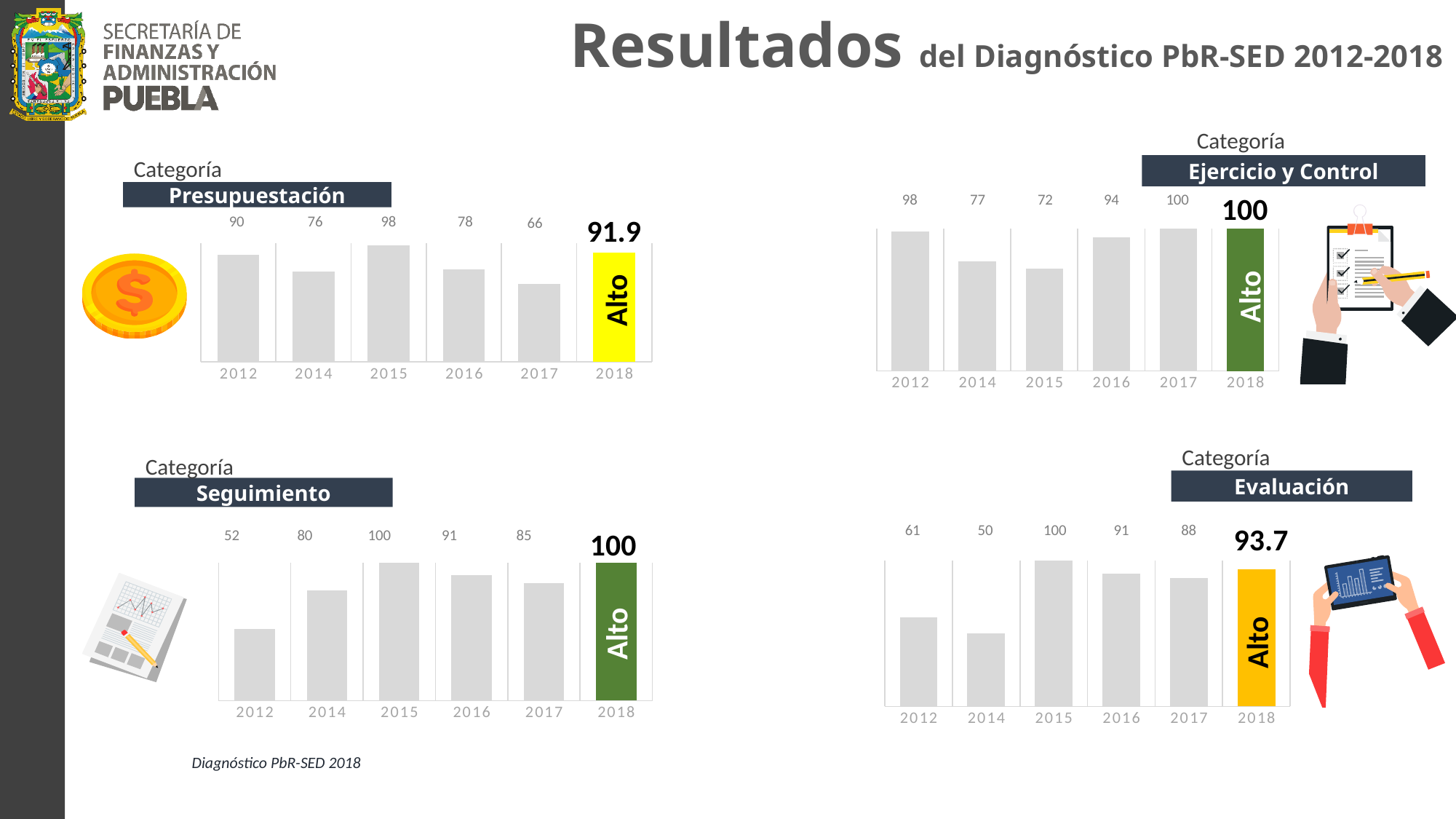
In the Evaluación chart, what is the value for 2018? 93.7 In the Seguimiento chart, how many years are plotted? 6 In the Presupuestación chart, what is the value for 2018? 91.9 In the Seguimiento chart, what is the difference between the 2014 and 2012 values? 28 In the Ejercicio y Control chart, what is the value for 2014? 77 In the Seguimiento chart, what is the value for 2012? 52 In the Ejercicio y Control chart, is the value for 2012 or 2016 larger? 2012 In the Presupuestación chart, which year has the lowest value? 2017 In the Presupuestación chart, what is the difference between the 2015 and 2017 values? 32 What kind of chart is the Evaluación chart? Bar chart In the Evaluación chart, which year has the highest value? 2015 In the Ejercicio y Control chart, which year has the lowest value? 2015